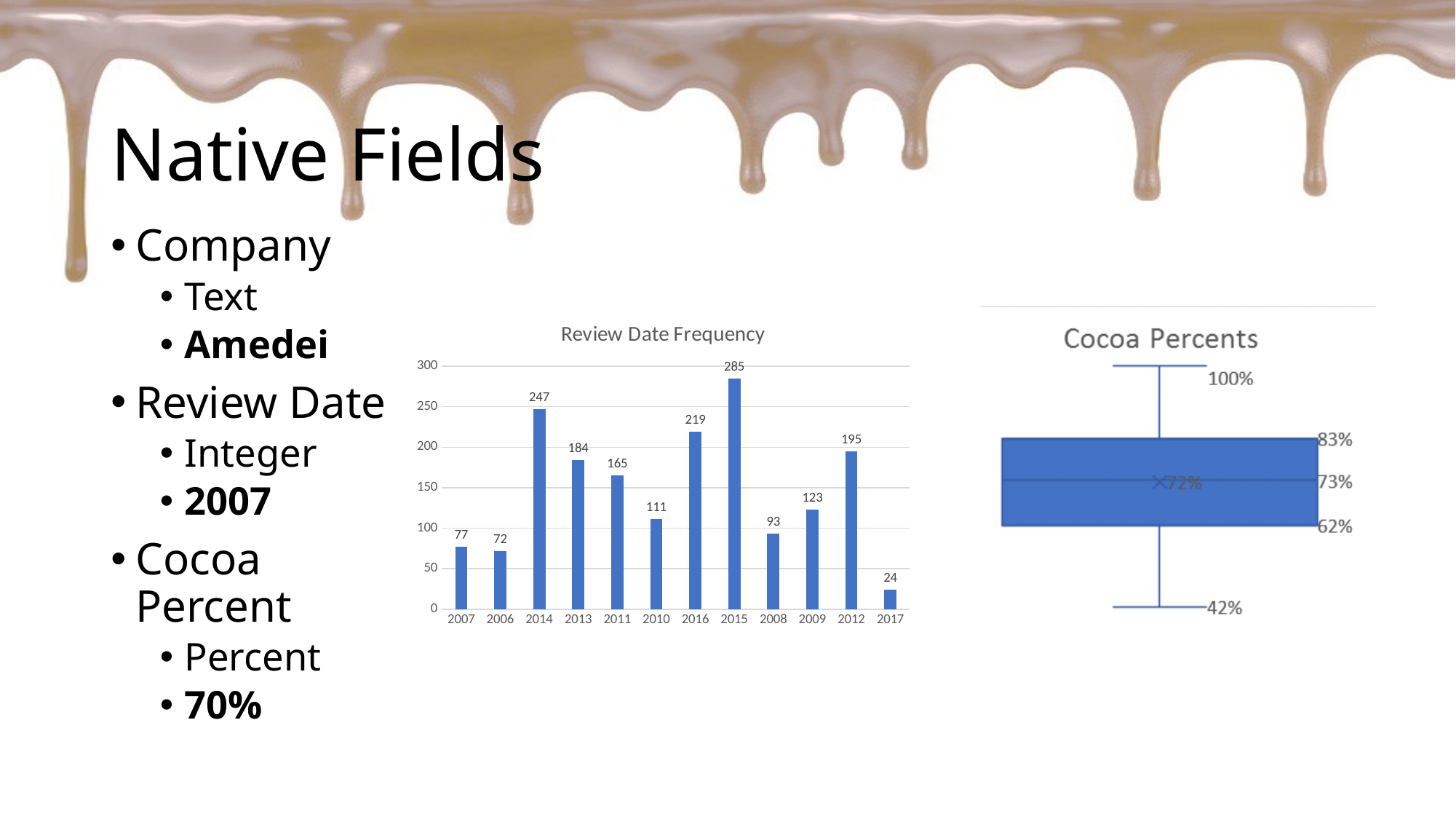
What kind of chart is the Review Date Frequency chart? Bar chart In the Cocoa Percents chart, what is the mean value marked with an x? 72% In the Cocoa Percents chart, what is the minimum value shown at the bottom whisker? 42% In the Cocoa Percents chart, what is the difference between the upper and lower edges of the box (83% and 62%)? 21% In the Review Date Frequency chart, which is larger, the value for 2013 or the value for 2012? 2012 In the Cocoa Percents chart, what is the maximum value shown at the top whisker? 100% In the Review Date Frequency chart, how many years are shown on the x axis? 12 In the Review Date Frequency chart, which year has the highest value? 2015 In the Review Date Frequency chart, what is the value for 2010? 111 In the Review Date Frequency chart, what is the value for 2014? 247 In the Review Date Frequency chart, what is the difference between the values for 2015 and 2016? 66 In the Review Date Frequency chart, which year has the lowest value? 2017